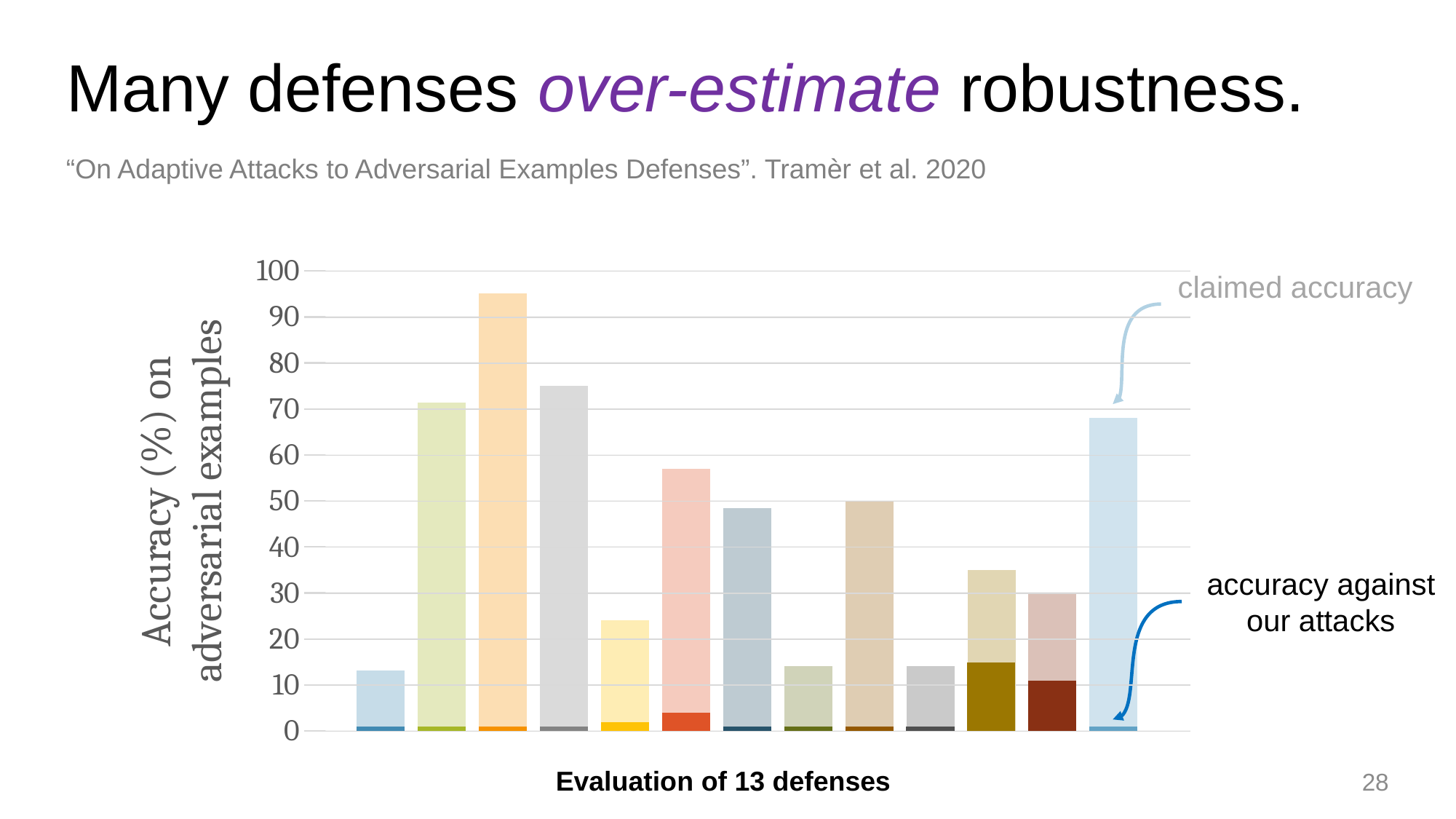
Is the accuracy against the authors' attacks for the first bar from the left greater or less than 10? less What does the lighter, taller portion of each bar represent, according to the annotation? claimed accuracy Which bar, counting from the left, has the highest claimed accuracy? the third bar What kind of chart is shown on the slide? bar chart Is the claimed accuracy of the fifth bar from the left greater or less than 30? less Is the claimed accuracy of the fourth bar from the left greater or less than 70? greater What is the y-axis title of the chart? Accuracy (%) on adversarial examples How many defenses are evaluated in the chart, according to the x-axis label? 13 Which has the higher claimed accuracy: the sixth bar from the left or the seventh bar from the left? the sixth bar